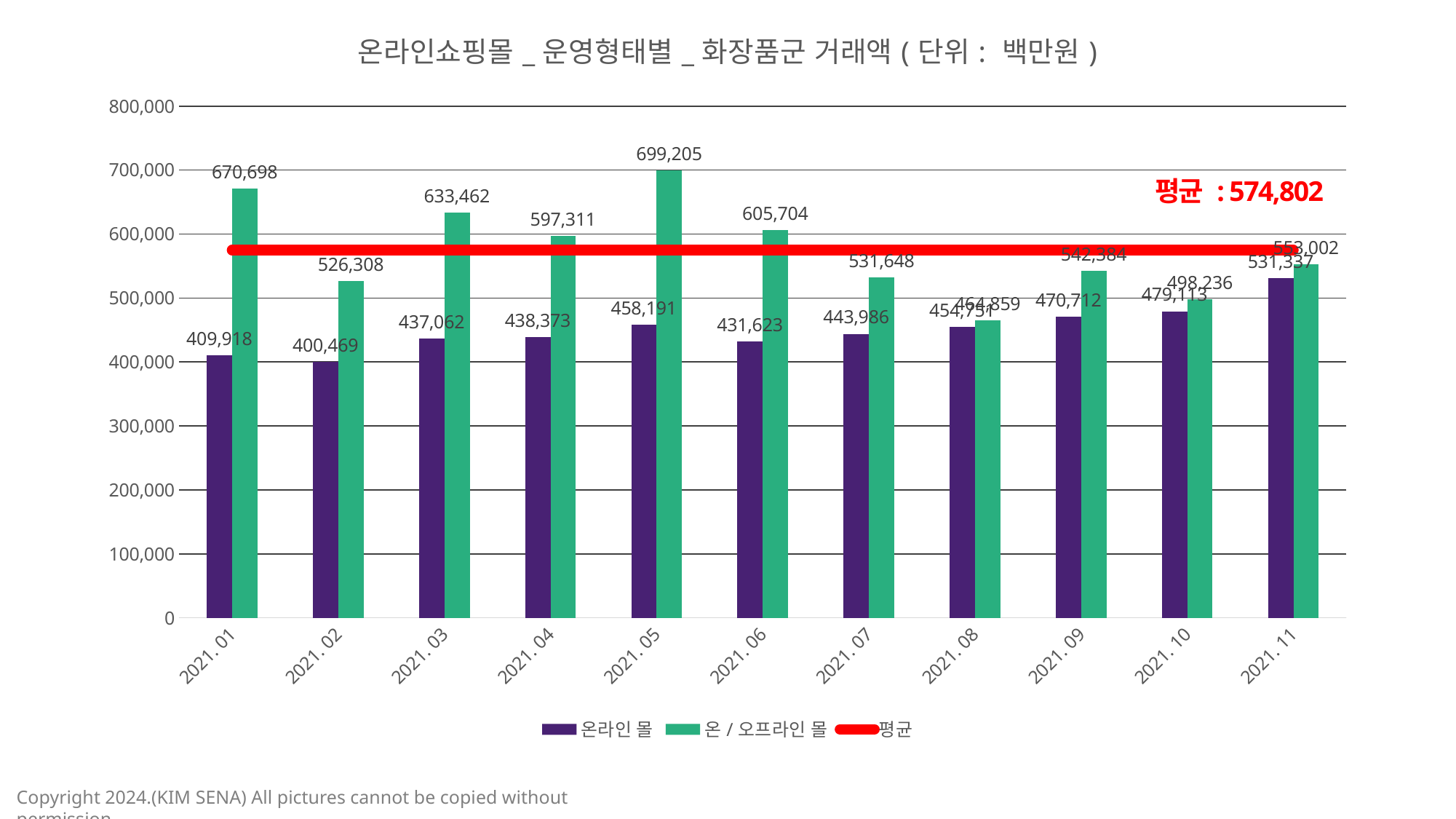
In 2021. 07, which series has the larger value, 온라인 몰 or 온 / 오프라인 몰? 온 / 오프라인 몰 What kind of chart is shown on the slide? combination bar and line chart Is the value for 온라인 몰 in 2021. 10 greater or less than 500,000? less What is the value for 온 / 오프라인 몰 in 2021. 05? 699,205 In which month is the 온라인 몰 value highest? 2021. 11 In which month is the 온 / 오프라인 몰 value highest? 2021. 05 What is the value for 온라인 몰 in 2021. 02? 400,469 In which month is the 온라인 몰 value lowest? 2021. 02 How many months are shown on the x axis? 11 How many entries does the legend list? 3 What is the difference between 온 / 오프라인 몰 and 온라인 몰 in 2021. 01? 260,780 What is the value for 온라인 몰 in 2021. 09? 470,712